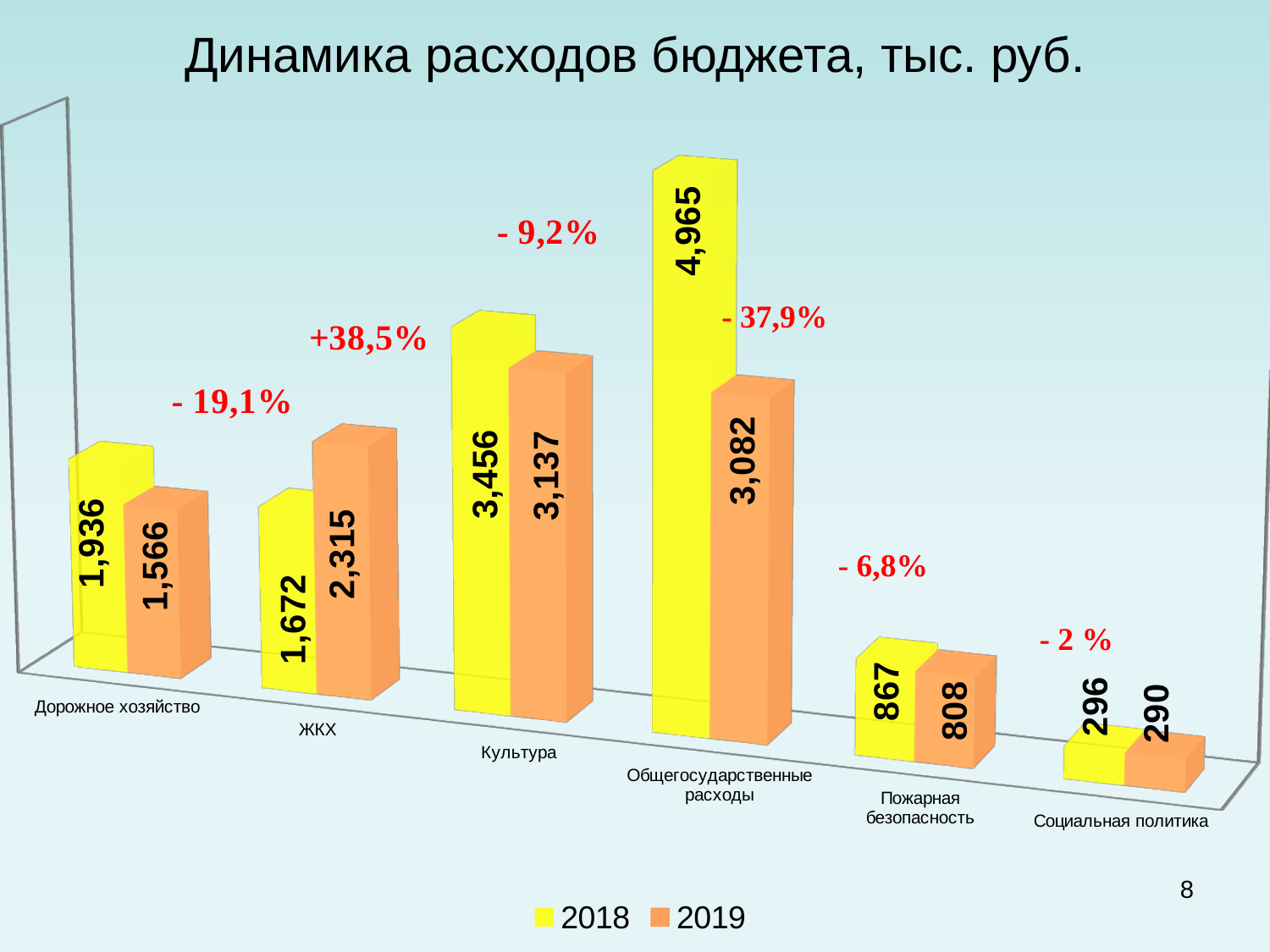
What is the difference between the 2018 and 2019 values for Дорожное хозяйство? 370 How many series does the legend list? 2 What is the 2018 value for Общегосударственные расходы? 4,965 What is the 2018 value for Социальная политика? 296 What is the difference between the 2019 and 2018 values for ЖКХ? 643 What is the 2019 value for Пожарная безопасность? 808 Which category has the highest 2018 value? Общегосударственные расходы What is the 2019 value for ЖКХ? 2,315 What type of chart is shown on the slide? Bar chart How many categories are shown on the chart? 6 Which is larger for Культура: the 2018 value or the 2019 value? 2018 Which category has the lowest 2019 value? Социальная политика